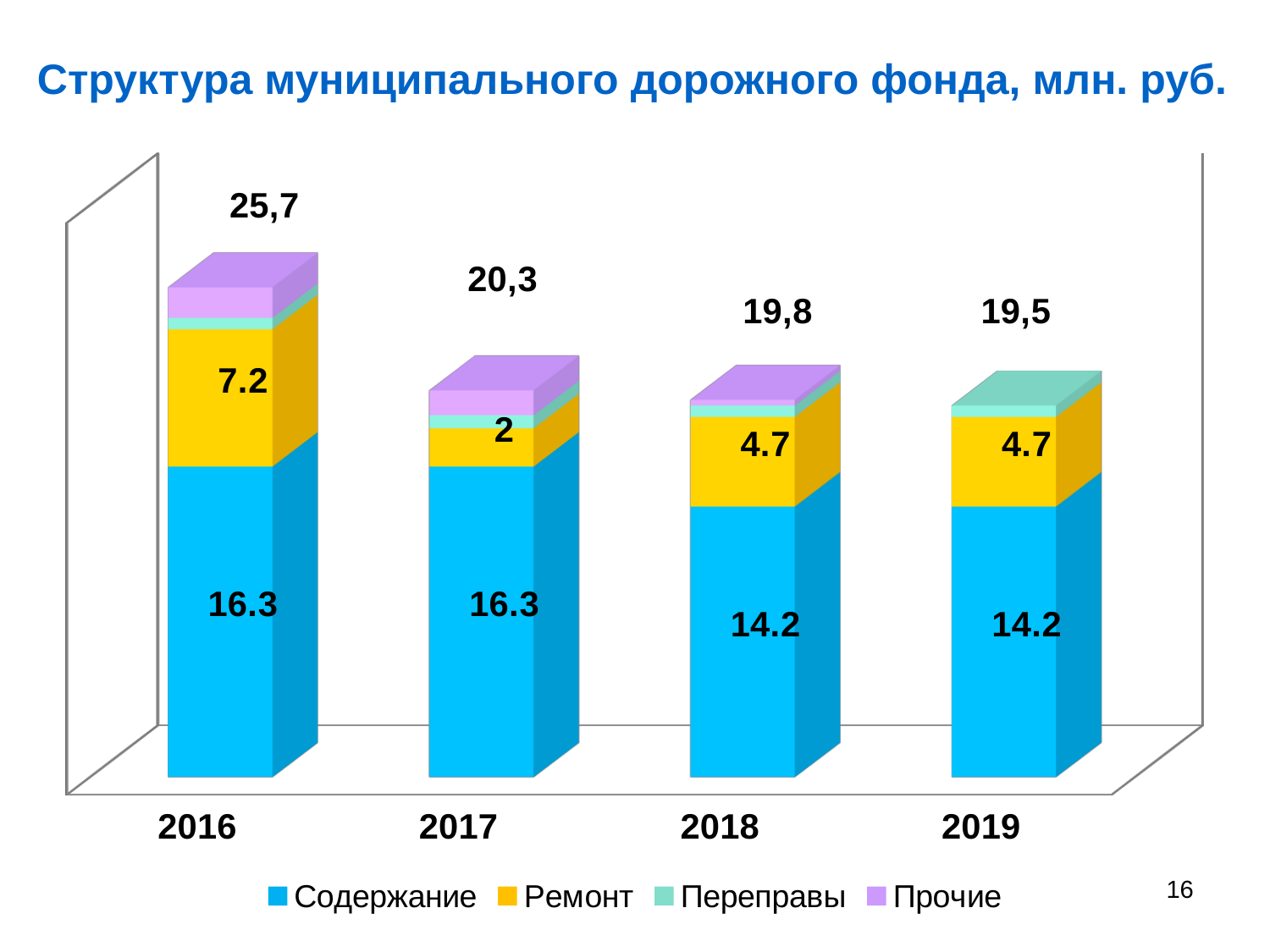
What is the difference between the Ремонт values for 2016 and 2017? 5.2 What is the value of Ремонт for 2017? 2 What is the value of Содержание for 2016? 16.3 What is the total shown above the bar for 2019? 19,5 Which year has the lowest total? 2019 What type of chart is shown on the slide? stacked bar chart What is the value of Ремонт for 2018? 4.7 Which year has the highest total? 2016 How many series does the legend list? 4 What is the total shown above the bar for 2016? 25,7 What is the value of Содержание for 2019? 14.2 How many years are shown on the x axis? 4